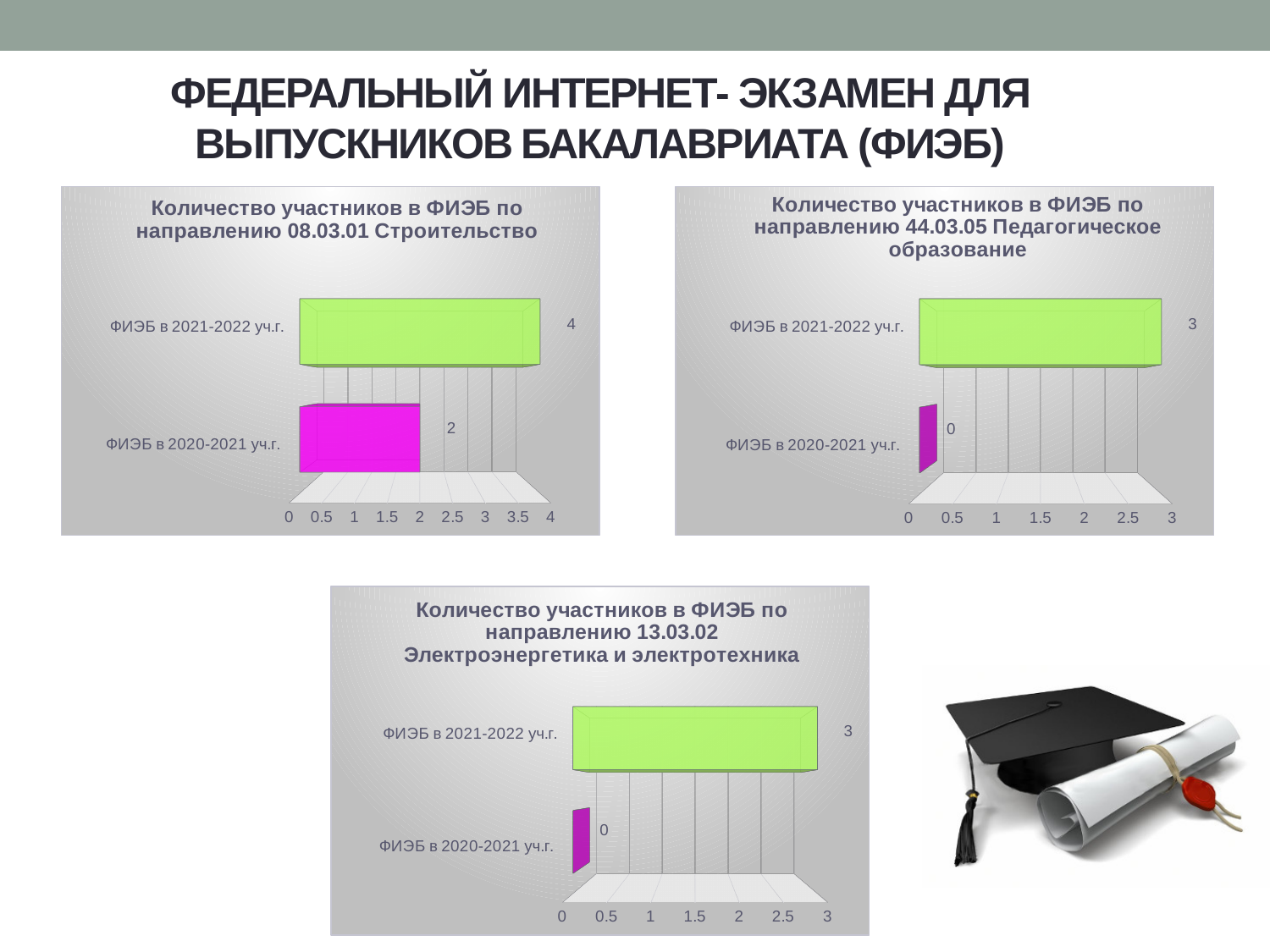
In the chart titled 'Количество участников в ФИЭБ по направлению 13.03.02 Электроэнергетика и электротехника', what is the value for ФИЭБ в 2021-2022 уч.г.? 3 In the chart titled 'Количество участников в ФИЭБ по направлению 44.03.05 Педагогическое образование', which category has the lowest value? ФИЭБ в 2020-2021 уч.г. In the chart titled 'Количество участников в ФИЭБ по направлению 08.03.01 Строительство', what is the value for ФИЭБ в 2021-2022 уч.г.? 4 In the chart titled 'Количество участников в ФИЭБ по направлению 08.03.01 Строительство', which category has the highest value? ФИЭБ в 2021-2022 уч.г. In the chart titled 'Количество участников в ФИЭБ по направлению 44.03.05 Педагогическое образование', what is the value for ФИЭБ в 2020-2021 уч.г.? 0 In the chart titled 'Количество участников в ФИЭБ по направлению 08.03.01 Строительство', what is the difference between the 2021-2022 and 2020-2021 values? 2 What kind of chart is the one titled 'Количество участников в ФИЭБ по направлению 13.03.02 Электроэнергетика и электротехника'? Bar chart In the chart titled 'Количество участников в ФИЭБ по направлению 08.03.01 Строительство', what is the value for ФИЭБ в 2020-2021 уч.г.? 2 In the chart titled 'Количество участников в ФИЭБ по направлению 13.03.02 Электроэнергетика и электротехника', what is the difference between the 2021-2022 and 2020-2021 values? 3 How many categories are shown in the chart titled 'Количество участников в ФИЭБ по направлению 08.03.01 Строительство'? 2 In the chart titled 'Количество участников в ФИЭБ по направлению 44.03.05 Педагогическое образование', what is the value for ФИЭБ в 2021-2022 уч.г.? 3 In the chart titled 'Количество участников в ФИЭБ по направлению 13.03.02 Электроэнергетика и электротехника', which is larger: the value for 2021-2022 or for 2020-2021? ФИЭБ в 2021-2022 уч.г.